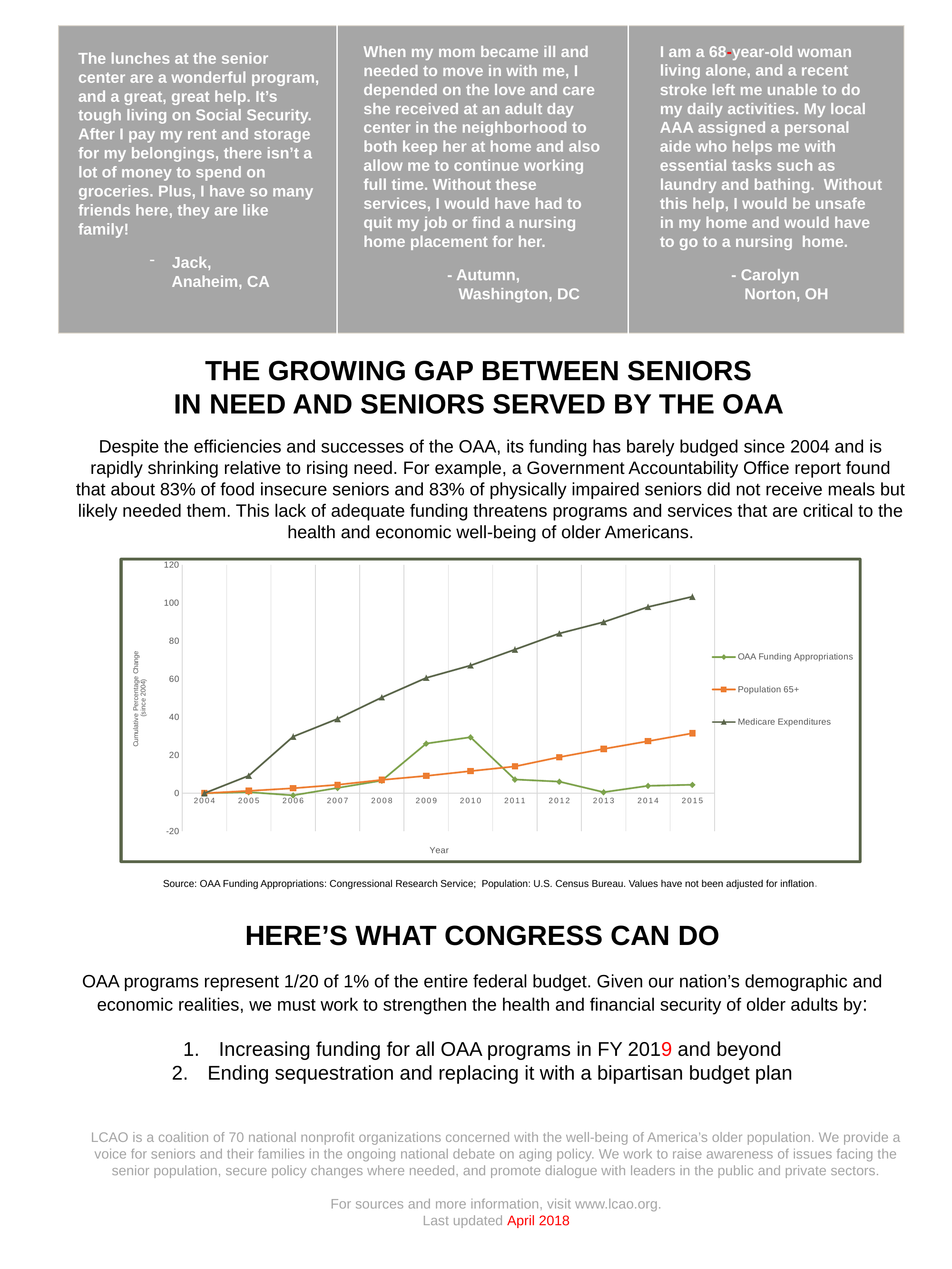
In 2015, which is larger: Medicare Expenditures or Population 65+? Medicare Expenditures Is the value for Population 65+ in 2015 greater or less than 40? less Is the value for Medicare Expenditures in 2015 greater or less than 100? greater Which series has the lowest value in 2015? OAA Funding Appropriations What is the title of the chart's x axis? Year How many series does the chart's legend list? 3 In 2009, which is larger: OAA Funding Appropriations or Population 65+? OAA Funding Appropriations What kind of chart is shown on the slide? line chart Is the value for OAA Funding Appropriations in 2010 greater or less than 20? greater How many years are plotted along the x axis of the chart? 12 Do the values for Medicare Expenditures rise or fall from 2004 to 2015? rise